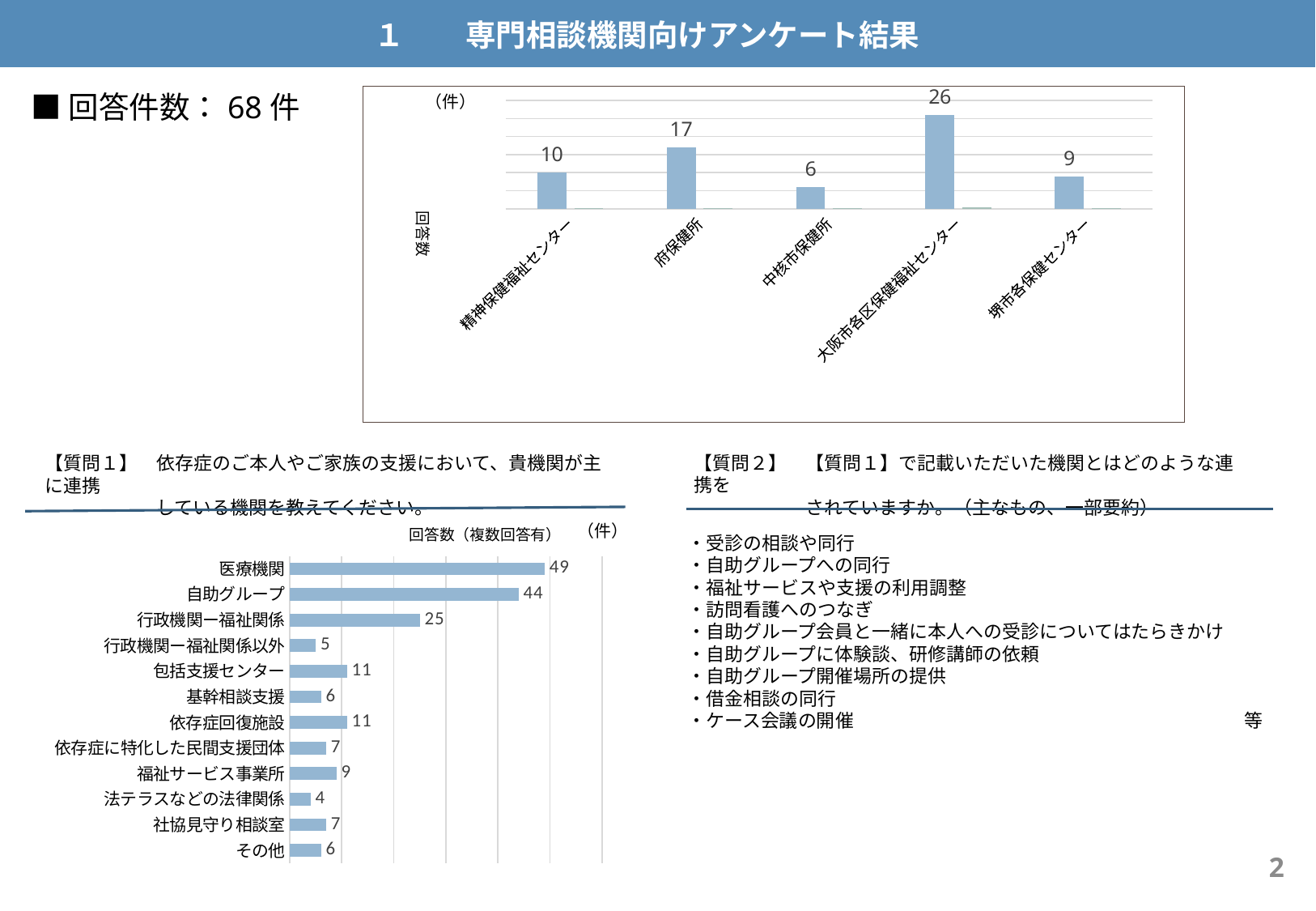
In the bottom-left chart, what is the difference between 医療機関 and 行政機関ー福祉関係? 24 In the bottom-left chart, which category has the lowest value? 法テラスなどの法律関係 In the top chart, what is the difference between 精神保健福祉センター and 堺市各保健センター? 1 What kind of chart is the bottom-left chart? Bar chart In the top chart, what is the value for 大阪市各区保健福祉センター? 26 In the top chart, how many categories are shown? 5 In the bottom-left chart, what is the value for 自助グループ? 44 In the bottom-left chart, which category has the highest value? 医療機関 In the top chart, what is the value for 府保健所? 17 In the bottom-left chart, how many categories are shown? 12 In the top chart, which category has the lowest value? 中核市保健所 In the bottom-left chart, which is larger, 包括支援センター or 福祉サービス事業所? 包括支援センター